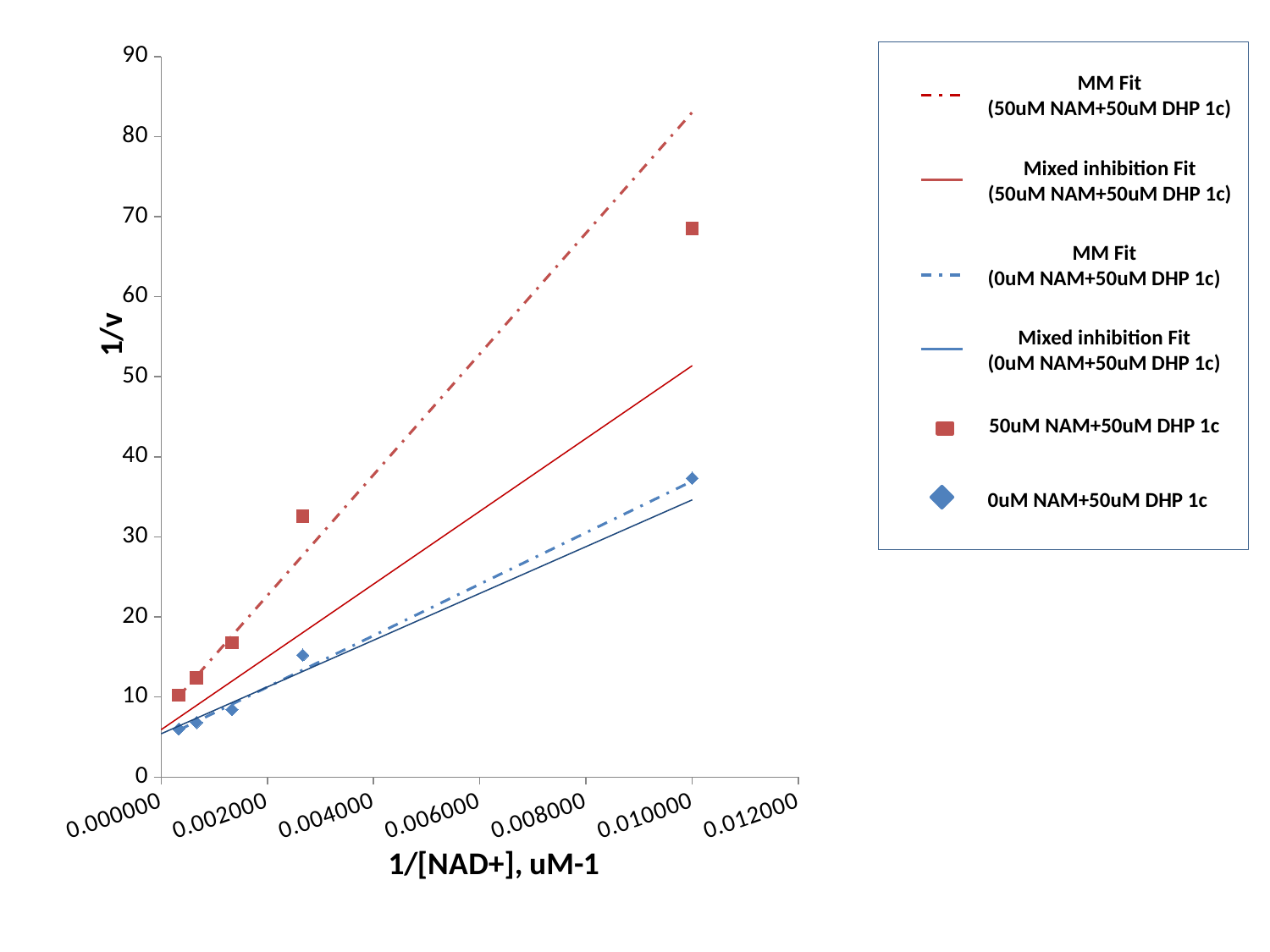
Is the 1/v value of the 50uM NAM+50uM DHP 1c data point near 1/[NAD+] = 0.003 greater or less than 30? greater How many data points are plotted for the 0uM NAM+50uM DHP 1c series? 5 What is the title of the y axis? 1/v Is the 1/v value of the 0uM NAM+50uM DHP 1c data point near 1/[NAD+] = 0.003 greater or less than 20? less Is the 1/v value of the highest 0uM NAM+50uM DHP 1c data point greater or less than 40? less What is the title of the x axis? 1/[NAD+], uM-1 How many entries does the legend list? 6 How many data points are plotted for the 50uM NAM+50uM DHP 1c series? 5 At 1/[NAD+] of about 0.010, which series has the larger 1/v value: 50uM NAM+50uM DHP 1c or 0uM NAM+50uM DHP 1c? 50uM NAM+50uM DHP 1c What kind of chart is shown on the slide? scatter chart Do the 1/v values rise or fall as 1/[NAD+] increases? rise